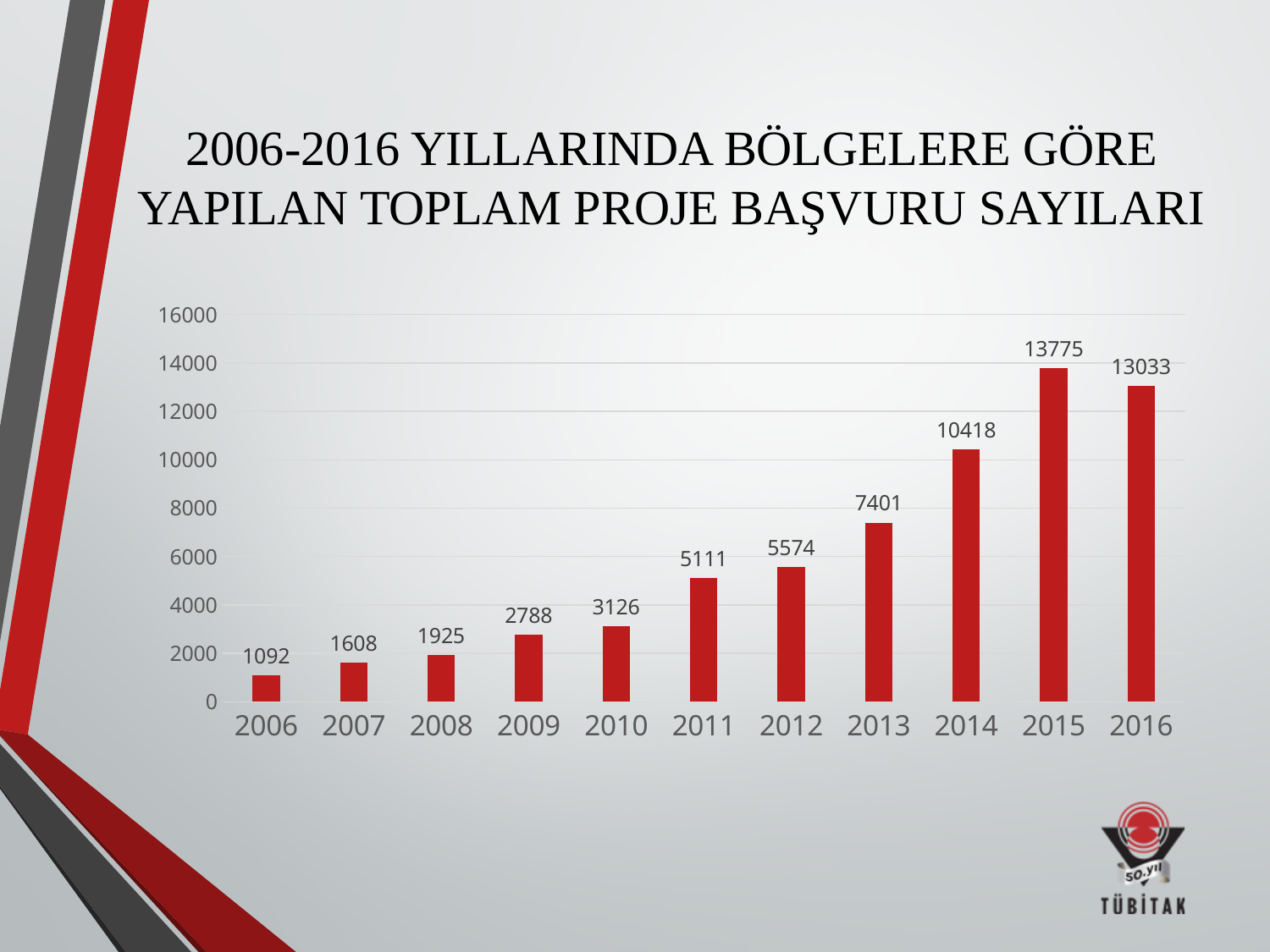
How many years are shown on the x axis? 11 What colour are the bars in the chart? red What is the value for 2010? 3126 Which is larger, the value for 2011 or the value for 2012? 2012 What is the value for 2014? 10418 Is the value for 2014 greater or less than 10000? greater Do the values generally rise or fall from 2006 to 2015? rise Which year has the lowest value? 2006 What kind of chart is shown on the slide? bar chart What is the difference between the values for 2013 and 2012? 1827 What is the difference between the values for 2015 and 2016? 742 Which year has the highest value? 2015